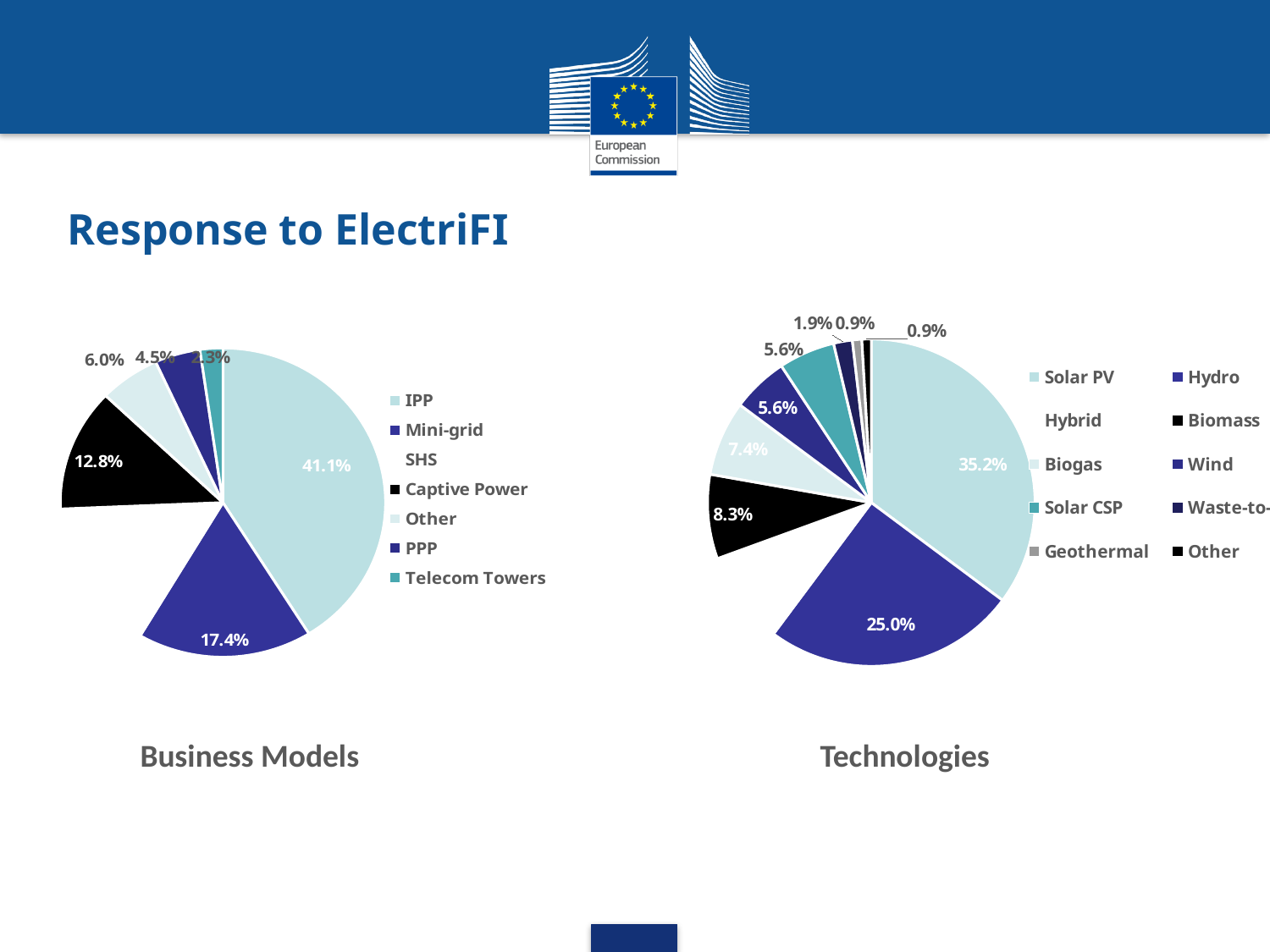
In the Business Models chart, what share does IPP have? 41.1% In the Business Models chart, how many percentage points larger is IPP than Mini-grid? 23.7 percentage points In the Technologies chart, which technology has the largest share? Solar PV In the Technologies chart, how many percentage points larger is Solar PV than Hydro? 10.2 percentage points In the Business Models chart, which business model has the largest share? IPP In the Business Models chart, what share does Captive Power have? 12.8% In the Business Models chart, what share does Mini-grid have? 17.4% In the Technologies chart, what share does Hydro have? 25.0% How many entries does the legend of the Business Models chart list? 7 In the Technologies chart, which is larger, Solar PV or Hydro? Solar PV What type of chart is used for Business Models? Pie chart In the Technologies chart, what share does Solar PV have? 35.2%